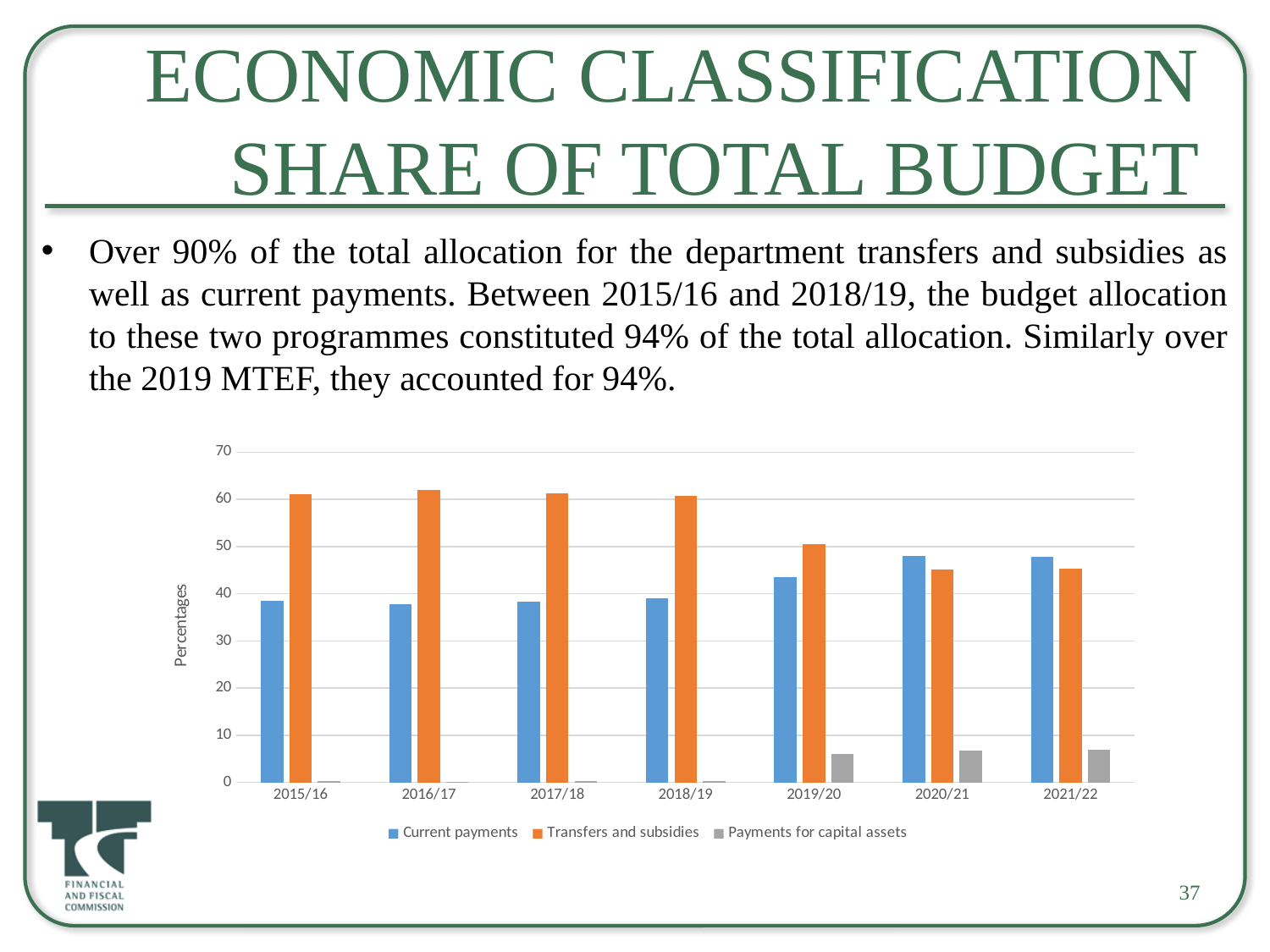
Is the value for Payments for capital assets in 2021/22 greater or less than 10? less Do the values for Transfers and subsidies rise or fall from 2018/19 to 2021/22? fall Is the value for Transfers and subsidies in 2020/21 greater or less than 50? less What kind of chart is shown on the slide? bar chart Which series has the lowest value in 2019/20? Payments for capital assets In 2021/22, which is larger: Current payments or Transfers and subsidies? Current payments Is the value for Transfers and subsidies in 2016/17 greater or less than 60? greater In 2015/16, which is larger: Current payments or Transfers and subsidies? Transfers and subsidies How many financial years are shown on the x axis? 7 How many series does the legend list? 3 What is the label on the vertical axis? Percentages